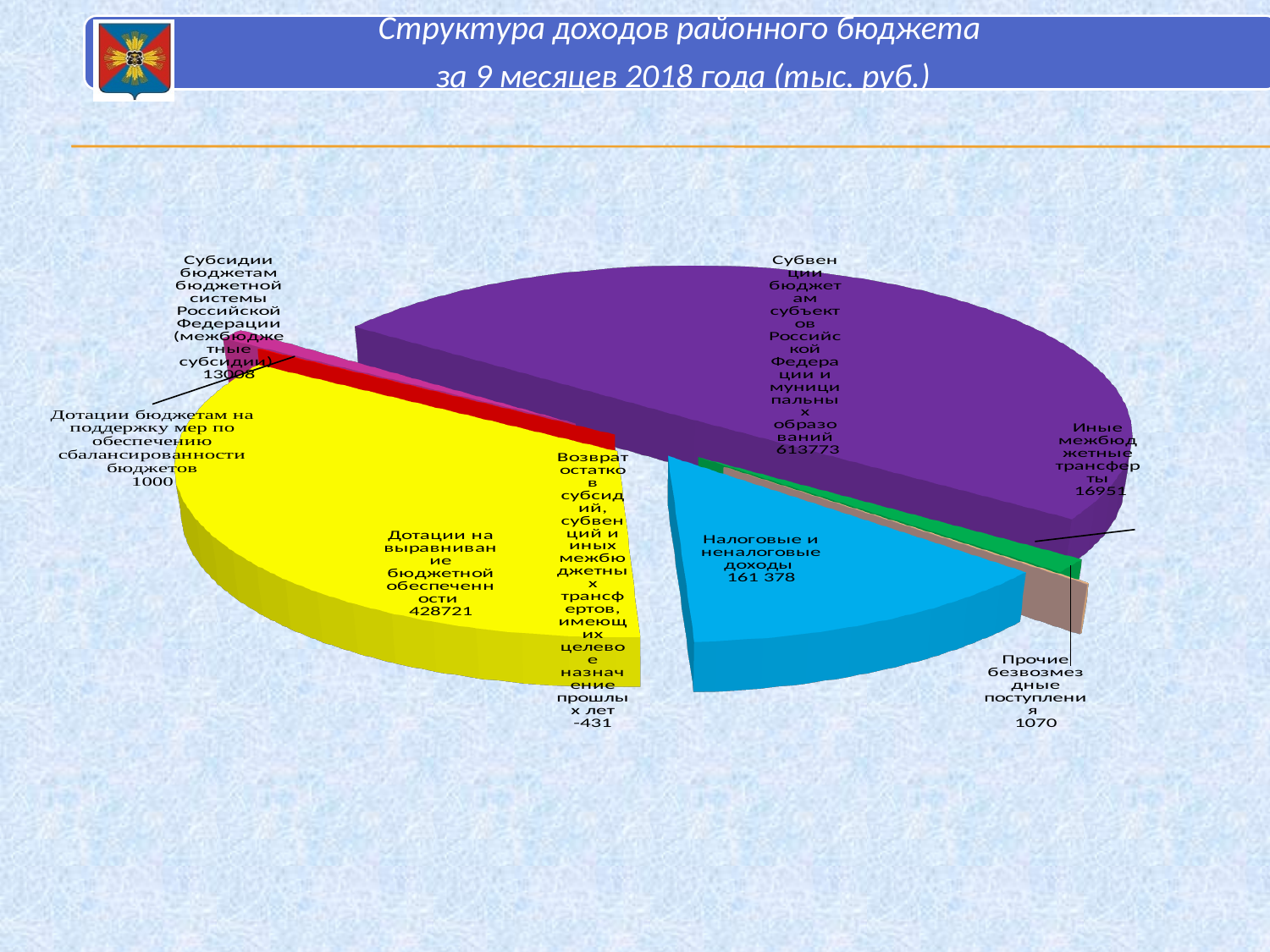
What is the value for Иные межбюджетные трансферты? 16951 What is the difference between the values for Субвенции бюджетам субъектов Российской Федерации и муниципальных образований and Дотации на выравнивание бюджетной обеспеченности? 185052 Which category has the lowest value? Возврат остатков субсидий, субвенций и иных межбюджетных трансфертов, имеющих целевое назначение прошлых лет Which is larger: Налоговые и неналоговые доходы or Иные межбюджетные трансферты? Налоговые и неналоговые доходы How many categories (slices) does the pie chart have? 8 Which category has the highest value? Субвенции бюджетам субъектов Российской Федерации и муниципальных образований What is the value for Дотации на выравнивание бюджетной обеспеченности? 428721 What type of chart is shown on the slide? Pie chart What is the value for Субвенции бюджетам субъектов Российской Федерации и муниципальных образований? 613773 What is the title of the chart? Структура доходов районного бюджета за 9 месяцев 2018 года (тыс. руб.) What is the value for Налоговые и неналоговые доходы? 161 378 What colour is the slice for Субвенции бюджетам субъектов Российской Федерации и муниципальных образований? Purple